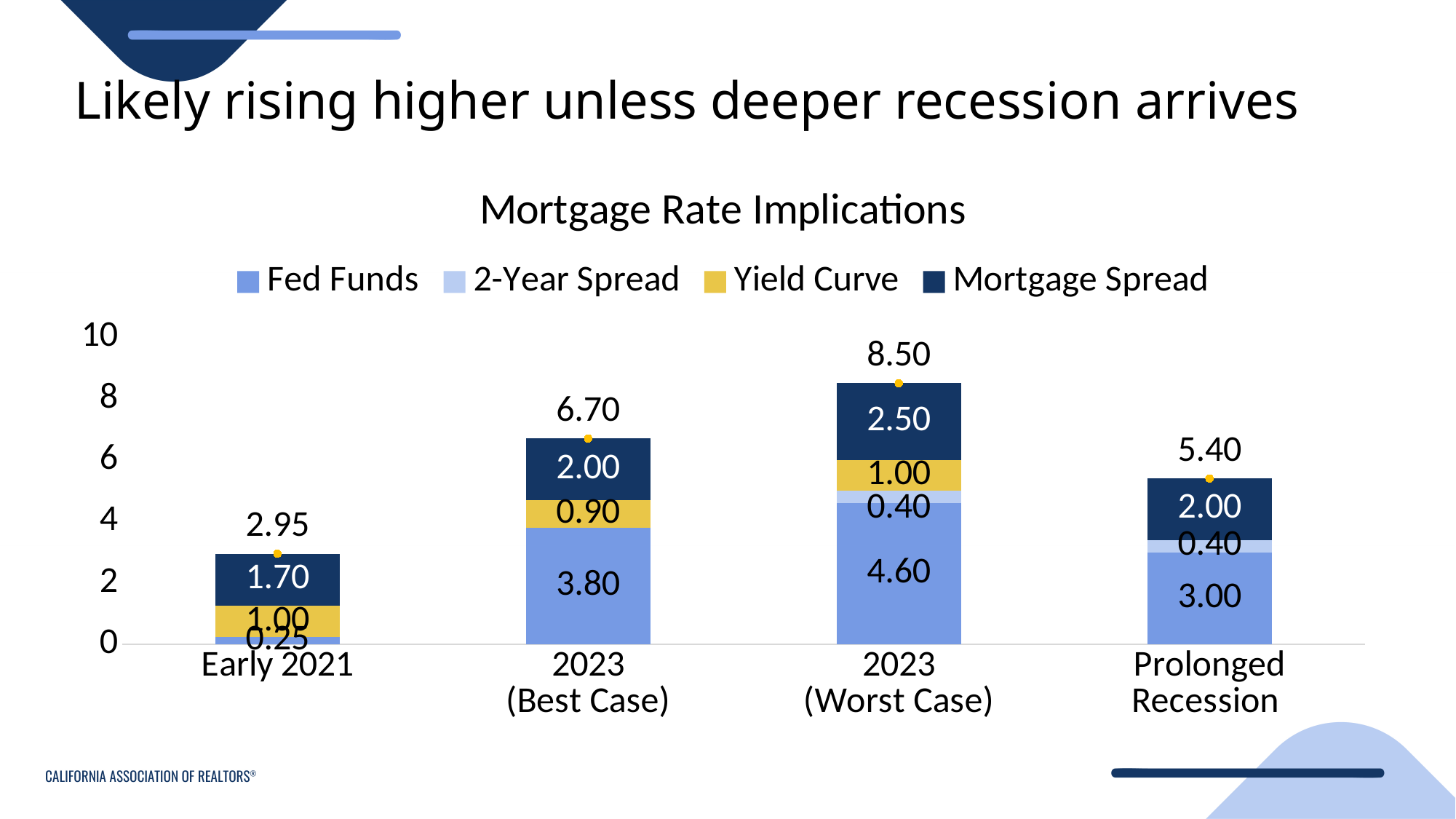
What kind of chart is shown on the slide? Stacked bar chart What is the Mortgage Spread value for Early 2021? 1.70 Which category has the lowest total? Early 2021 What is the total value shown above the bar for 2023 (Worst Case)? 8.50 Which category has the highest total? 2023 (Worst Case) What is the Fed Funds value for 2023 (Best Case)? 3.80 What is the difference between the totals for 2023 (Worst Case) and 2023 (Best Case)? 1.80 How many series does the legend list? 4 How many categories are shown on the x axis? 4 What is the title of the chart? Mortgage Rate Implications Which is larger, the Fed Funds value for 2023 (Worst Case) or for Prolonged Recession? 2023 (Worst Case) What is the 2-Year Spread value for Prolonged Recession? 0.40